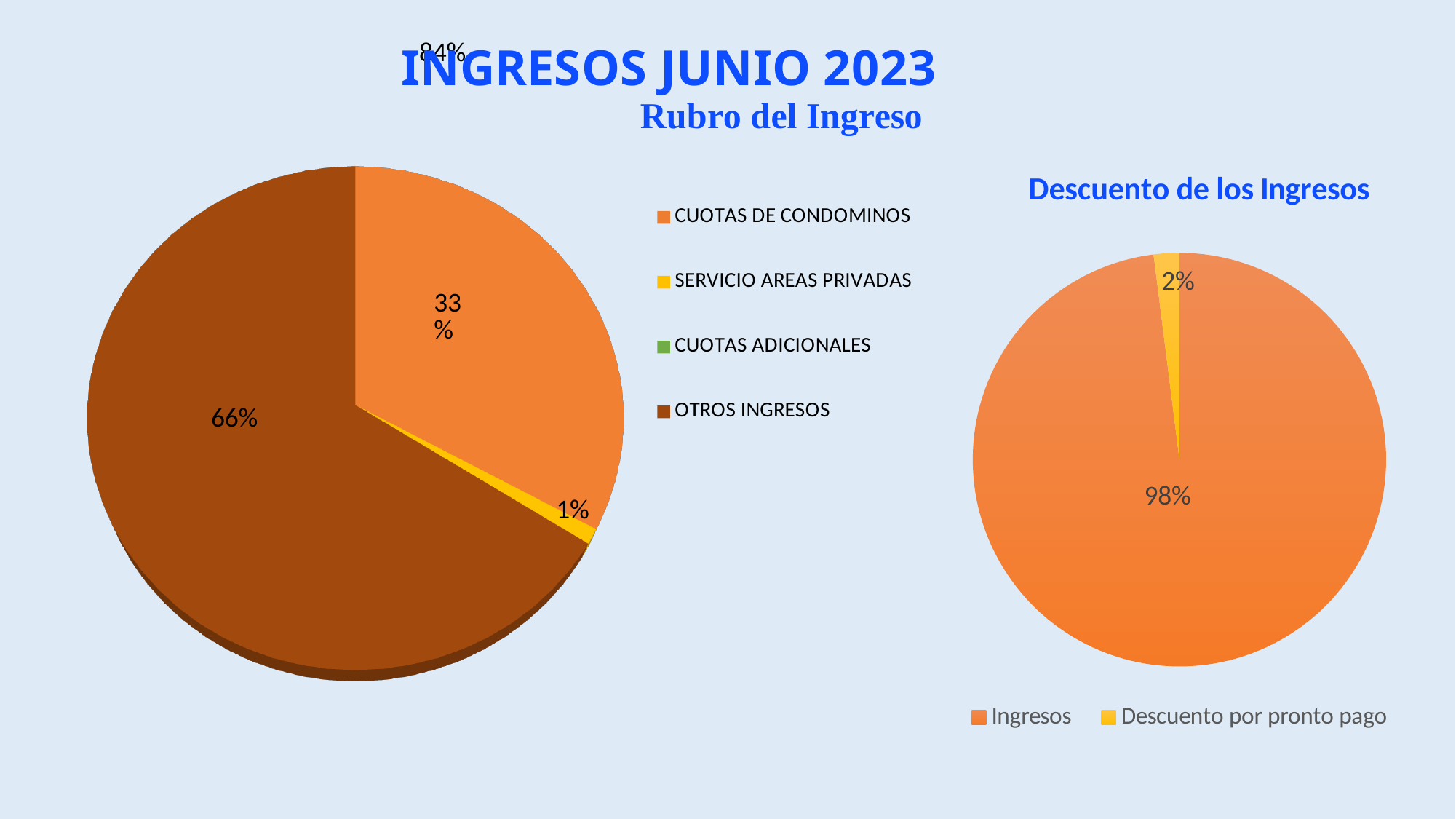
In the 'Rubro del Ingreso' chart, what is the difference between the OTROS INGRESOS share and the CUOTAS DE CONDOMINOS share? 33% In the 'Descuento de los Ingresos' chart, which slice is smaller? Descuento por pronto pago In the 'Rubro del Ingreso' chart, what share does SERVICIO AREAS PRIVADAS have? 1% In the 'Descuento de los Ingresos' chart, what share does Descuento por pronto pago have? 2% In the 'Rubro del Ingreso' chart, what share does OTROS INGRESOS have? 66% What kind of chart is the 'Rubro del Ingreso' chart? Pie chart What is the main title at the top of the slide? INGRESOS JUNIO 2023 In the 'Rubro del Ingreso' chart, which category has the largest slice? OTROS INGRESOS In the 'Descuento de los Ingresos' chart, how many entries does the legend list? 2 In the 'Rubro del Ingreso' chart, how many entries does the legend list? 4